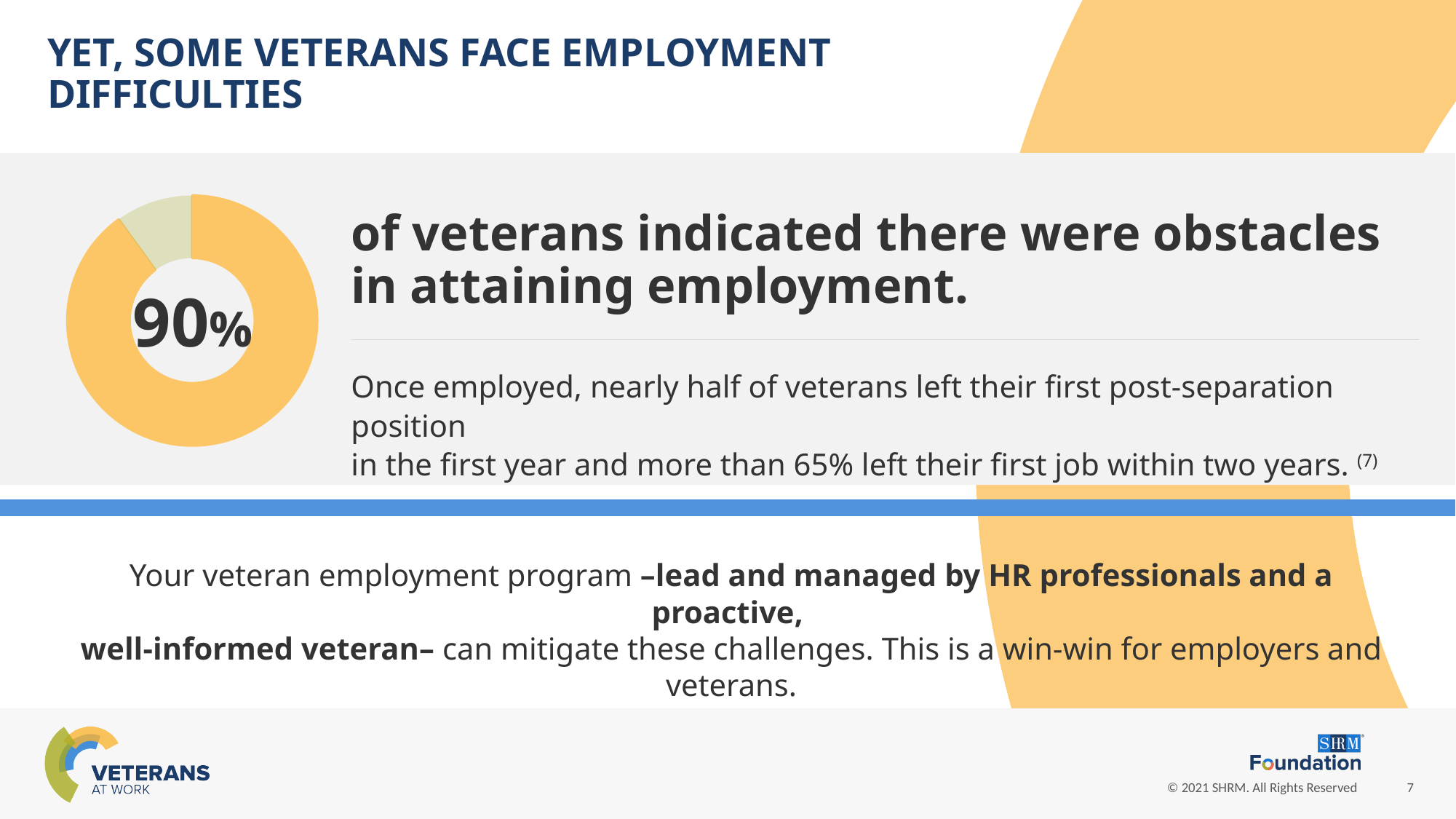
What share of the donut chart does the yellow segment represent? 90% What colour is the largest segment of the donut chart? Yellow Is the grey segment of the donut chart greater or less than 50% of the whole? less What kind of chart is shown on the left of the slide? Donut (pie) chart Which segment of the donut chart is larger, the yellow one or the grey one? Yellow Which segment of the donut chart is the smallest? The grey segment What percentage is printed in the centre of the donut chart? 90% What share of the donut chart does the grey segment represent? 10% According to the text next to the donut chart, what does the 90% figure represent? Veterans who indicated there were obstacles in attaining employment How many segments does the donut chart have? 2